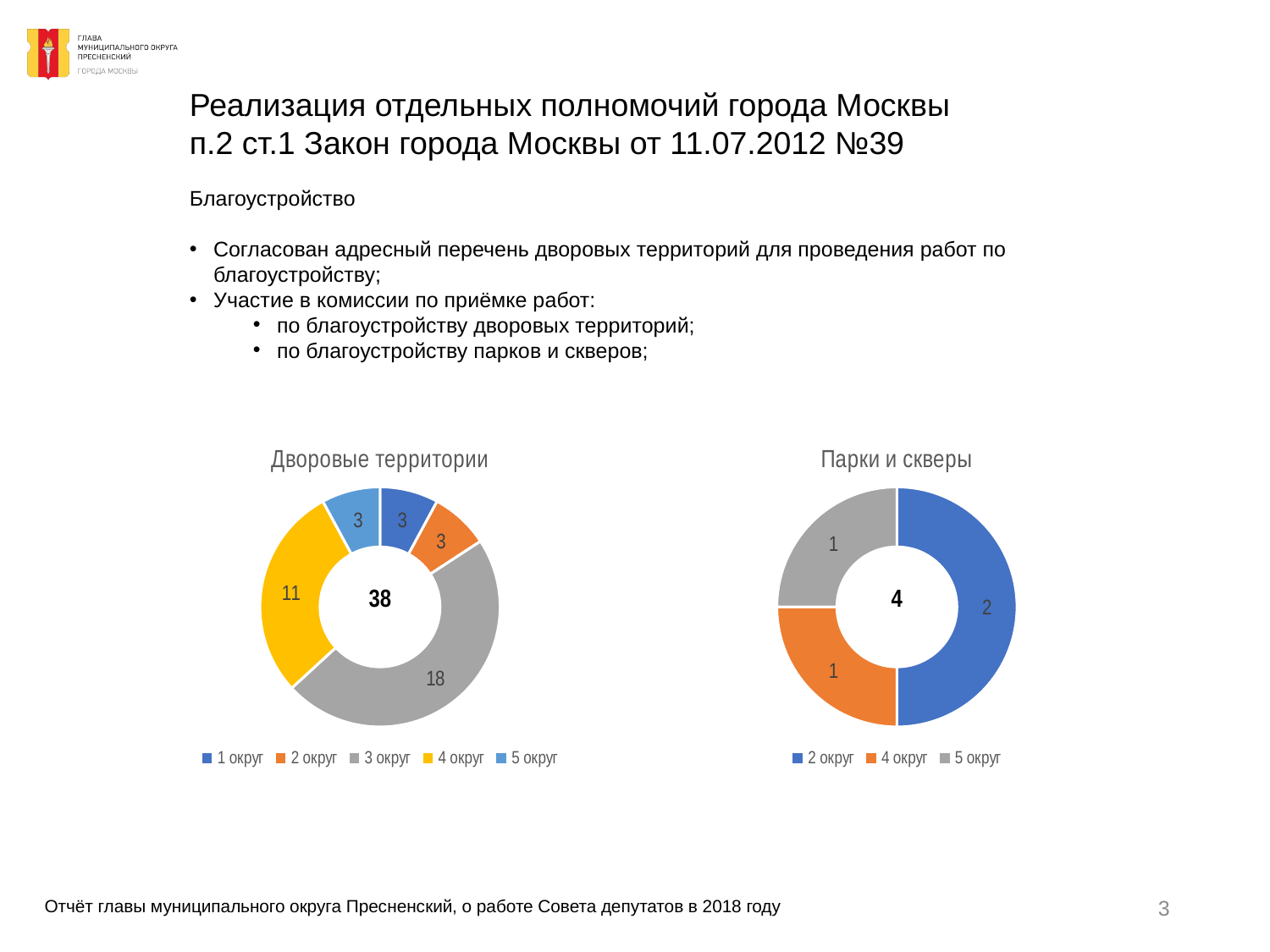
In the chart titled "Парки и скверы", how many categories does the legend list? 3 In the chart titled "Дворовые территории", what is the difference between the values for 3 округ and 4 округ? 7 In the chart titled "Парки и скверы", what is the value for 2 округ? 2 In the chart titled "Дворовые территории", what is the value for 4 округ? 11 In the chart titled "Дворовые территории", how many categories does the legend list? 5 What kind of chart is the chart titled "Парки и скверы"? Doughnut chart In the chart titled "Дворовые территории", which category has the highest value? 3 округ In the chart titled "Дворовые территории", is the value for 4 округ larger or smaller than the value for 2 округ? larger In the chart titled "Дворовые территории", what is the value for 3 округ? 18 In the chart titled "Парки и скверы", what share of the total does 2 округ represent? 50% In the chart titled "Парки и скверы", which category has the highest value? 2 округ In the chart titled "Дворовые территории", what total is shown in the centre of the doughnut? 38